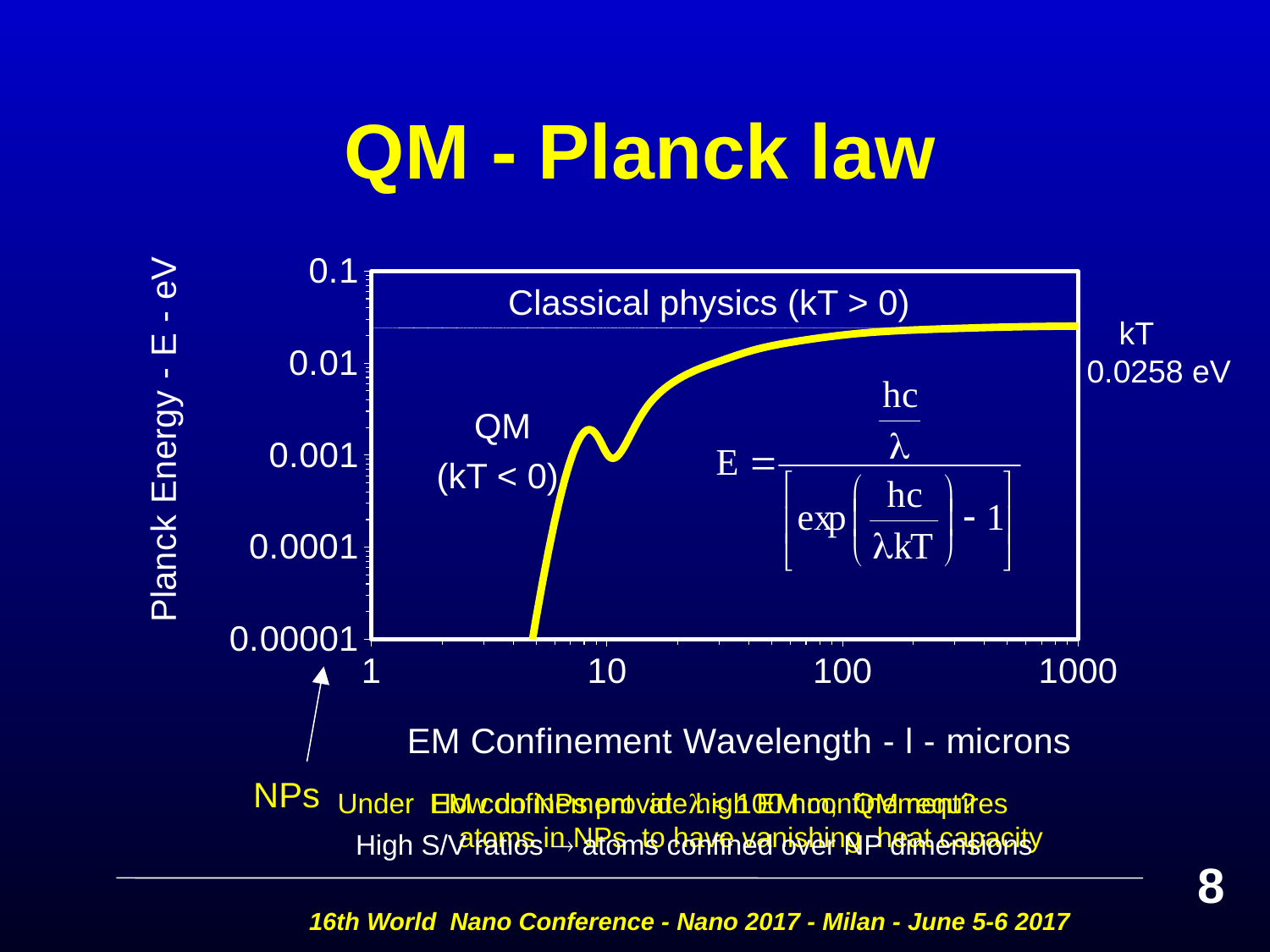
How many tick labels are shown on the x axis? 4 What kind of chart is shown on the slide? line chart Is the Planck energy at a wavelength of 100 microns greater or less than 0.01? greater Does the Planck energy curve rise or fall as the wavelength increases along the x axis? rise Is the Planck energy at a wavelength of 1000 microns greater or less than 0.1? less What value of kT is printed next to the chart? 0.0258 eV How many data series are plotted on the chart? 1 At which end of the x axis, 1 micron or 1000 microns, is the Planck energy higher? 1000 microns What is the label of the y axis? Planck Energy - E - eV How many tick labels are shown on the y axis? 5 Is the Planck energy at a wavelength of 1000 microns greater or less than 0.01? greater